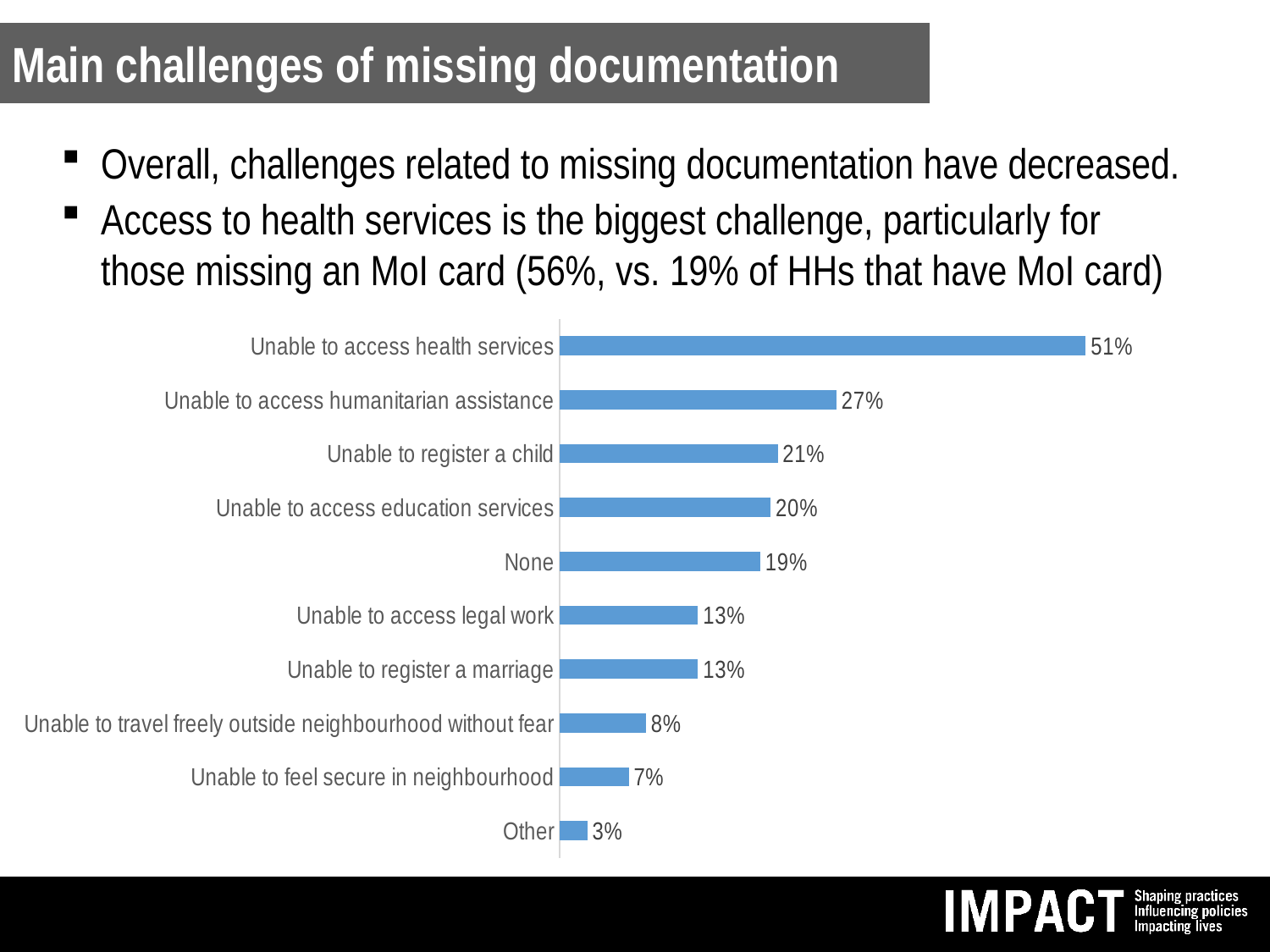
Which category has the lowest value? Other What is the title of the slide containing the chart? Main challenges of missing documentation What is the value for 'Unable to access health services'? 51% What is the value for 'None'? 19% What is the value for 'Unable to feel secure in neighbourhood'? 7% Which category has the highest value? Unable to access health services How many categories are shown in the chart? 10 What is the value for 'Unable to access humanitarian assistance'? 27% What kind of chart is shown on the slide? Bar chart Which is larger: 'Unable to access legal work' or 'Unable to travel freely outside neighbourhood without fear'? Unable to access legal work What is the difference between 'Unable to register a child' and 'Unable to access education services'? 1% What is the difference between 'Unable to access health services' and 'Unable to access humanitarian assistance'? 24%